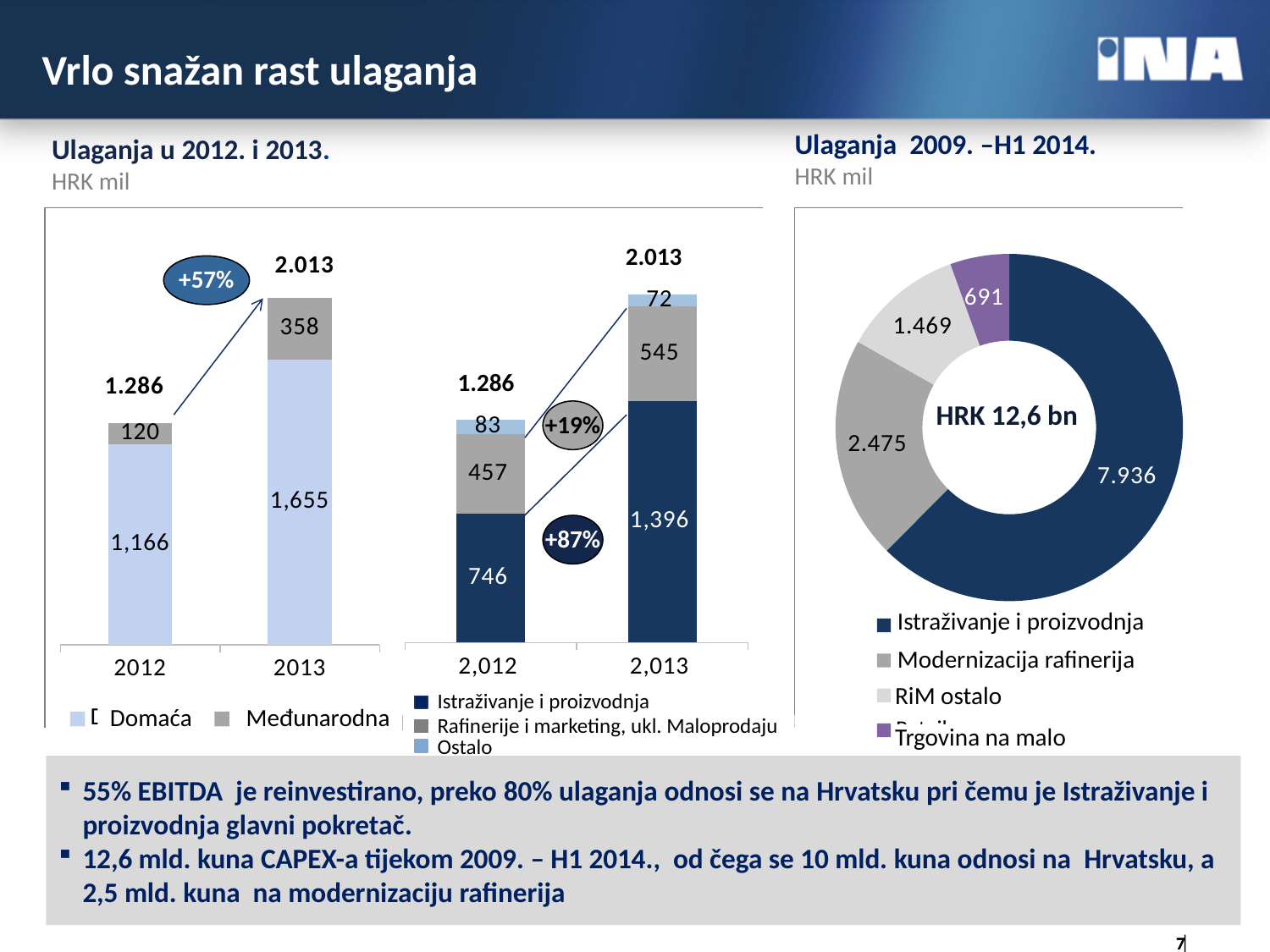
In the middle stacked bar chart, which is larger: Istraživanje i proizvodnja in 2012 or in 2013? 2013 In the middle stacked bar chart, what is the value of Ostalo for 2013? 72 In the right chart 'Ulaganja 2009. –H1 2014.', what is the value for Istraživanje i proizvodnja? 7.936 In the right chart 'Ulaganja 2009. –H1 2014.', what kind of chart is shown? Donut (pie) chart In the middle stacked bar chart, how many series does the legend list? 3 In the middle stacked bar chart, what is the value of Rafinerije i marketing, ukl. Maloprodaju for 2012? 457 In the left chart 'Ulaganja u 2012. i 2013.', what is the total of the stacked bar for 2013? 2.013 In the middle stacked bar chart, what is the value of Istraživanje i proizvodnja for 2013? 1,396 In the right chart 'Ulaganja 2009. –H1 2014.', which category has the smallest value? Trgovina na malo In the left chart 'Ulaganja u 2012. i 2013.', what percentage growth is shown between 2012 and 2013? +57% In the left chart 'Ulaganja u 2012. i 2013.', what is the value of Domaća for 2013? 1,655 In the left chart 'Ulaganja u 2012. i 2013.', what is the value of Međunarodna for 2012? 120